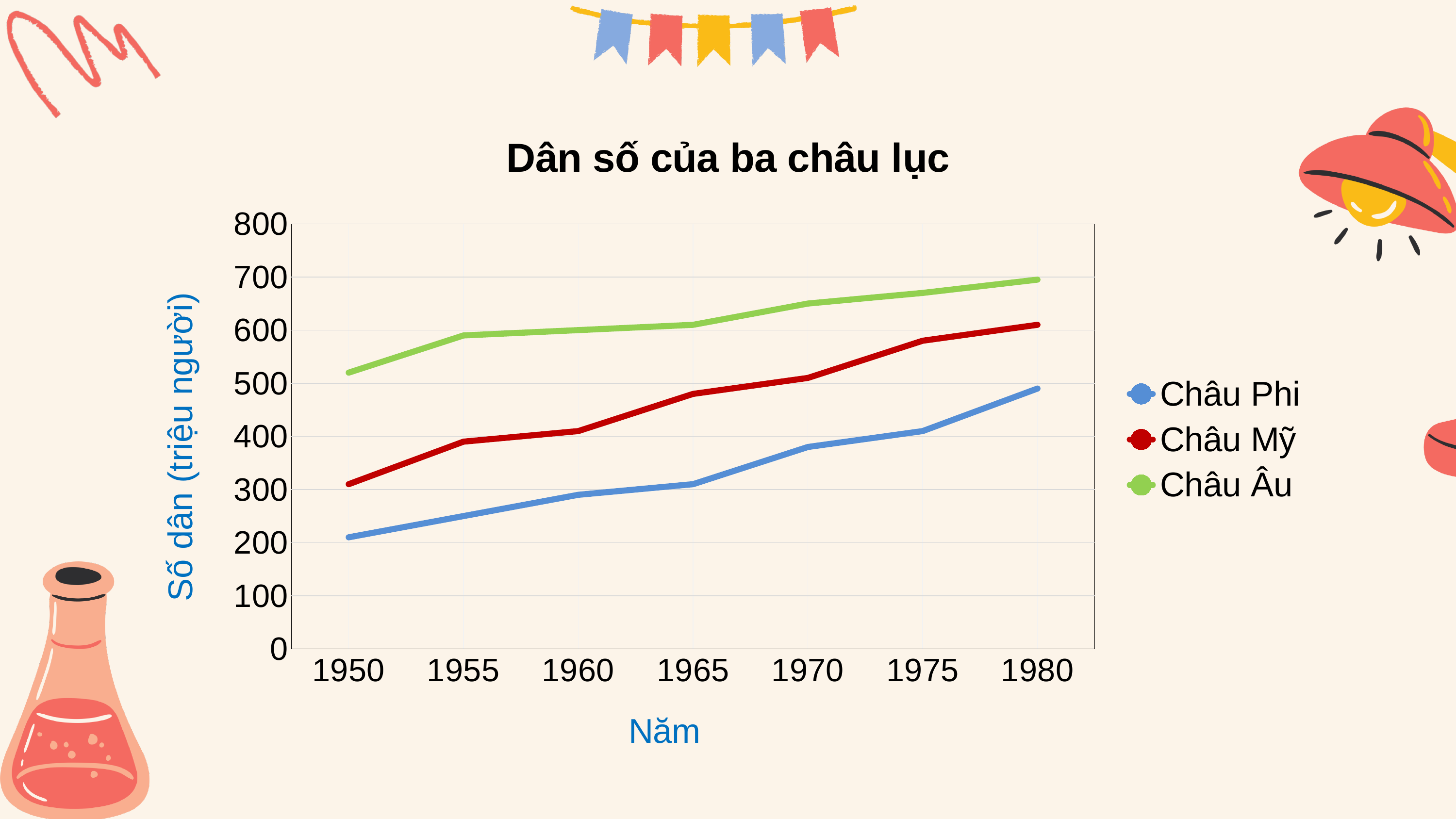
What is the title of the chart? Dân số của ba châu lục Is the value for Châu Mỹ in 1975 greater or less than 500? greater How many years are plotted along the x axis? 7 Is the value for Châu Phi in 1970 greater or less than 400? less Does the Châu Phi line rise or fall from 1950 to 1980? rise Is the value for Châu Âu in 1970 greater or less than 600? greater How many series does the legend list? 3 Which series has the highest population in 1950? Châu Âu Which is larger in 1965, the value for Châu Mỹ or the value for Châu Phi? Châu Mỹ What kind of chart is shown on the slide? line chart Which series has the lowest population in 1980? Châu Phi